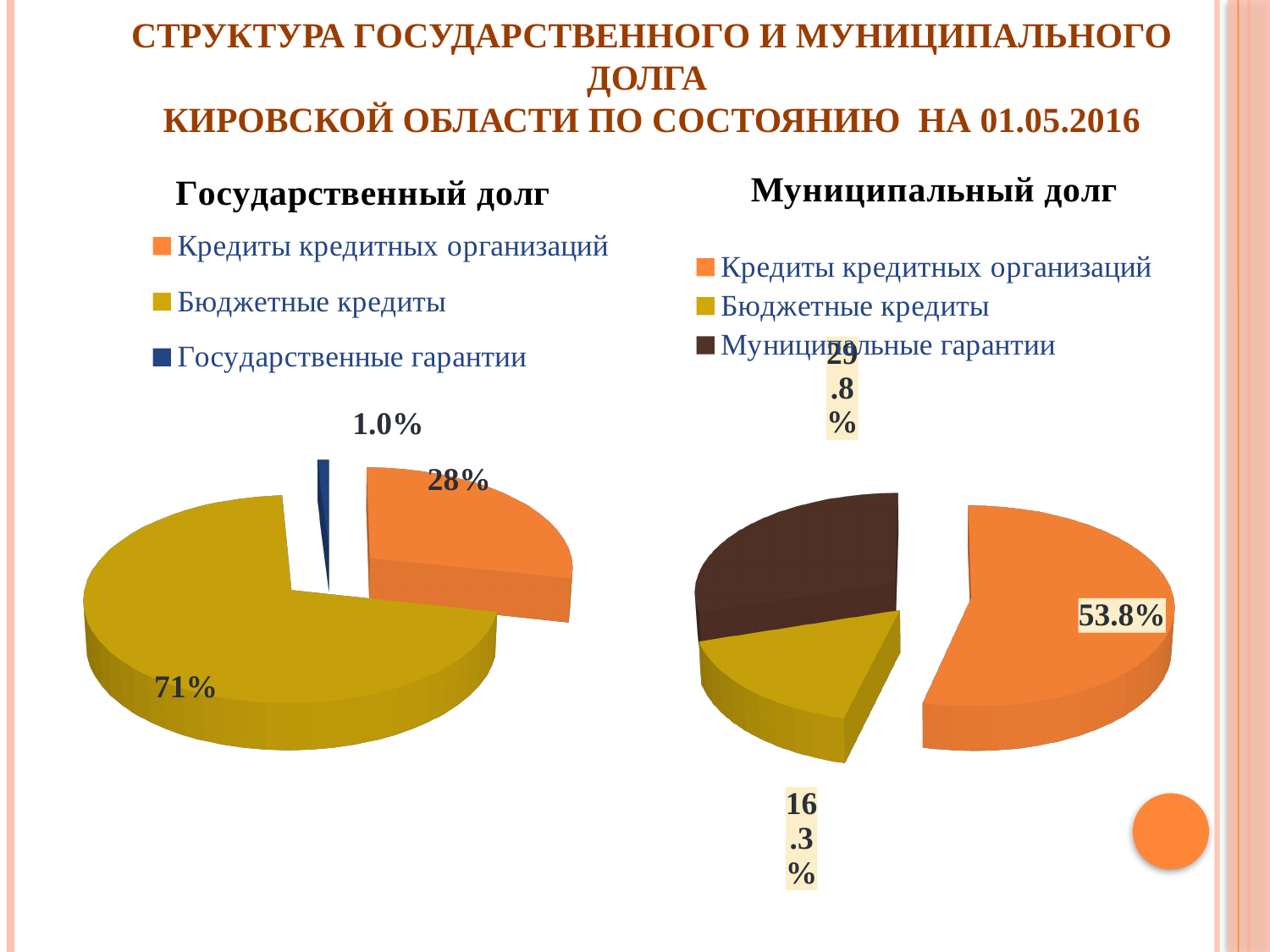
In the "Государственный долг" chart, what is the difference between the shares of Бюджетные кредиты and Кредиты кредитных организаций? 43 percentage points In the "Государственный долг" chart, what share is shown for Кредиты кредитных организаций? 28% In the "Муниципальный долг" chart, what share is shown for Кредиты кредитных организаций? 53.8% In the "Муниципальный долг" chart, which category has the largest slice? Кредиты кредитных организаций How many categories does the legend of the "Муниципальный долг" chart list? 3 In the "Государственный долг" chart, which category has the smallest slice? Государственные гарантии In the "Государственный долг" chart, what share is shown for Государственные гарантии? 1.0% What kind of chart is used for the "Государственный долг" chart? pie chart In the "Государственный долг" chart, which category has the largest slice? Бюджетные кредиты In the "Муниципальный долг" chart, what share is shown for Бюджетные кредиты? 16.3% In the "Государственный долг" chart, what share is shown for Бюджетные кредиты? 71% In the "Муниципальный долг" chart, which slice is larger: Муниципальные гарантии or Бюджетные кредиты? Муниципальные гарантии